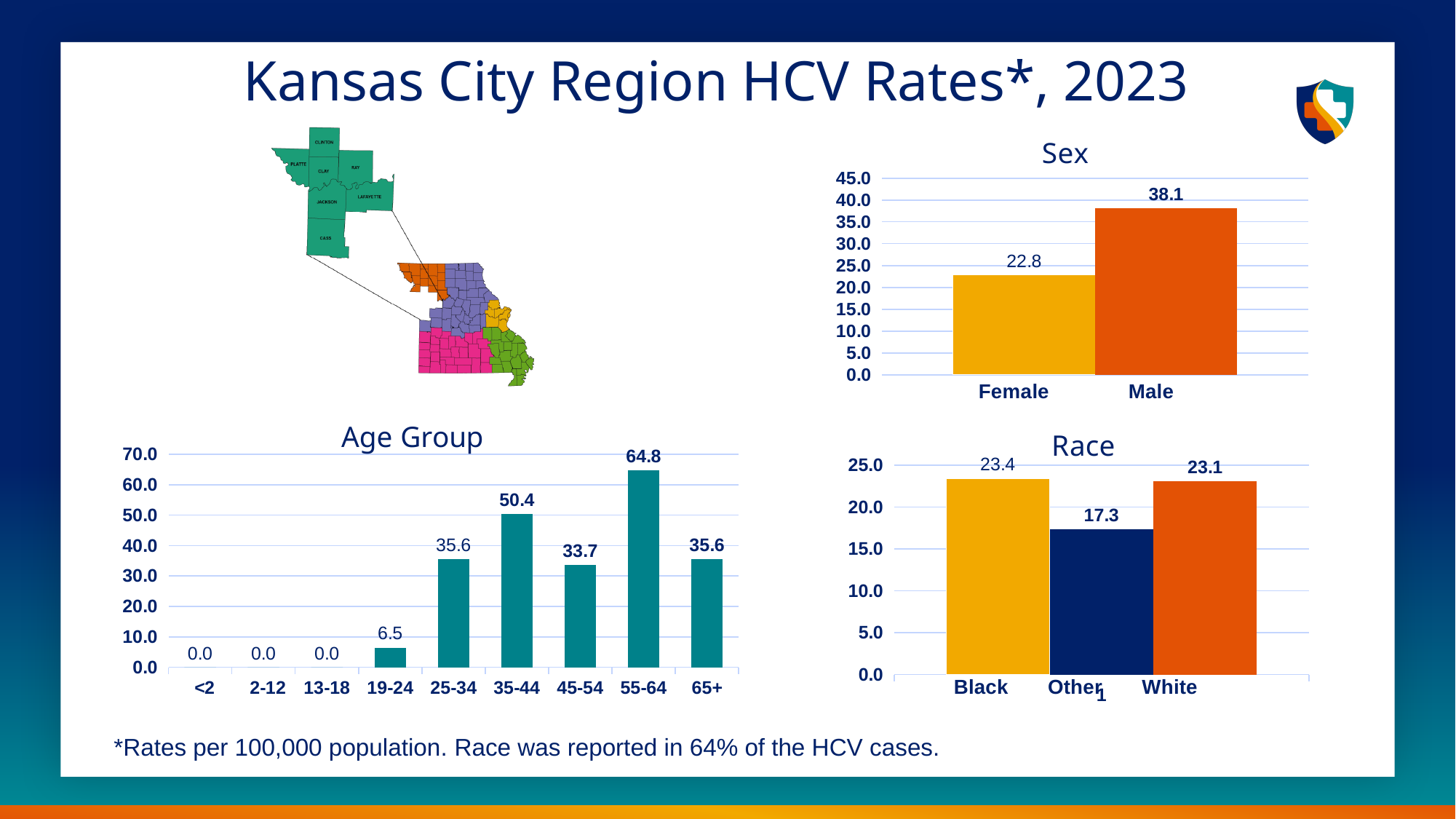
What kind of chart is the Race chart? Bar chart In the Age Group chart, which age group has the highest rate? 55-64 In the Age Group chart, what is the rate for the 19-24 age group? 6.5 In the Age Group chart, what is the rate for the 35-44 age group? 50.4 In the Sex chart, what is the HCV rate for Male? 38.1 In the Sex chart, what is the HCV rate for Female? 22.8 In the Race chart, what is the difference between the Black and White rates? 0.3 In the Sex chart, what is the difference between the Male and Female rates? 15.3 In the Race chart, which race category has the lowest rate? Other In the Race chart, what is the rate for Black? 23.4 In the Age Group chart, how many age group categories are shown on the x axis? 9 In the Age Group chart, which is larger, the rate for 45-54 or the rate for 65+? 65+